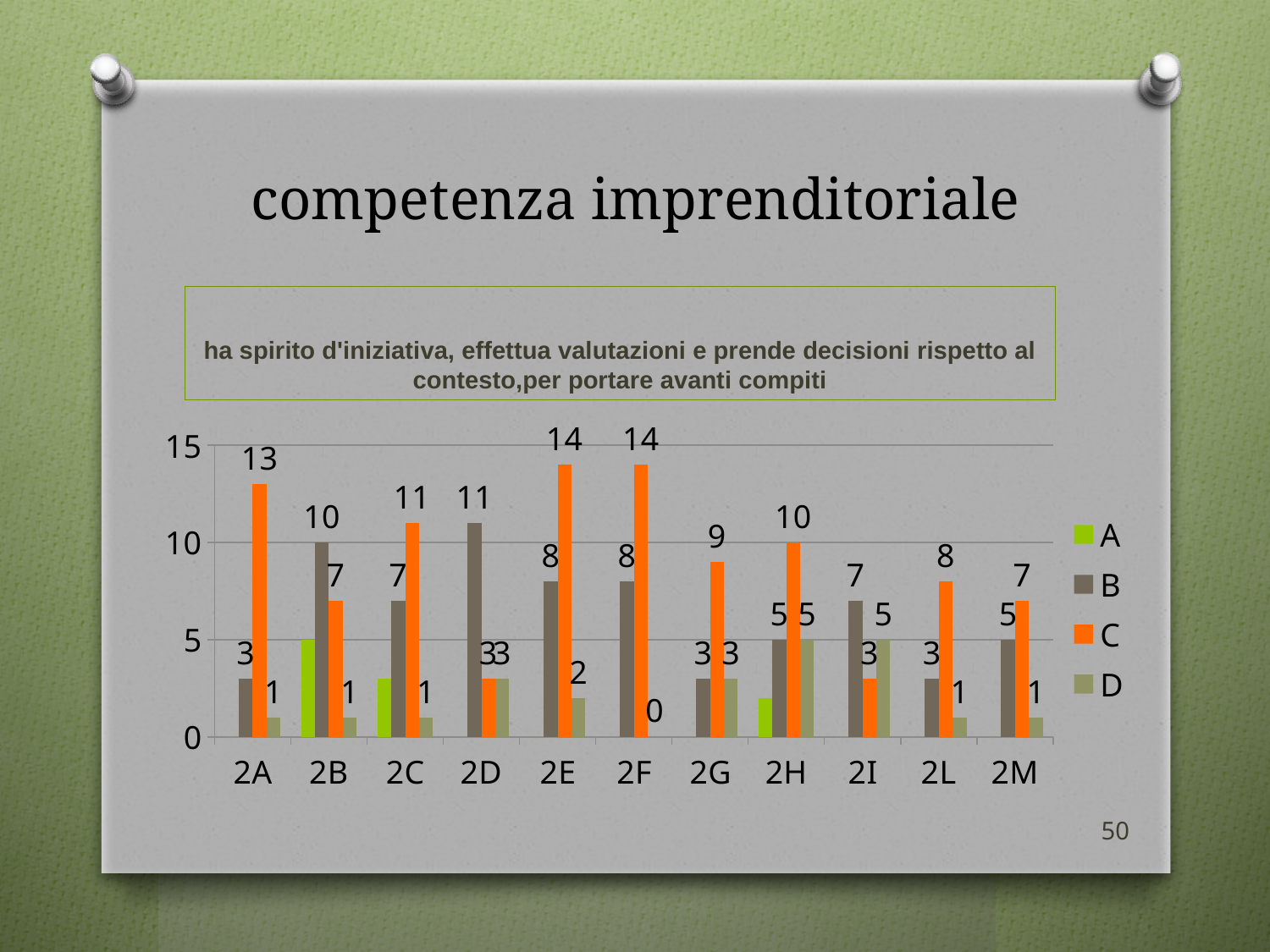
How many series does the legend list? 4 For category 2E, what is the difference between the value of series C and the value of series B? 6 Which category has the highest value for series B? 2D How many categories are shown on the x axis? 11 What is the value of series D for category 2I? 5 Is the value of series A for category 2C greater or less than 5? less What colour are the bars for series C? orange For category 2B, which series has the larger value, B or C? B What kind of chart is shown on the slide? bar chart What is the value of series B for category 2D? 11 Which category has the lowest value for series D? 2F What is the value of series C for category 2A? 13